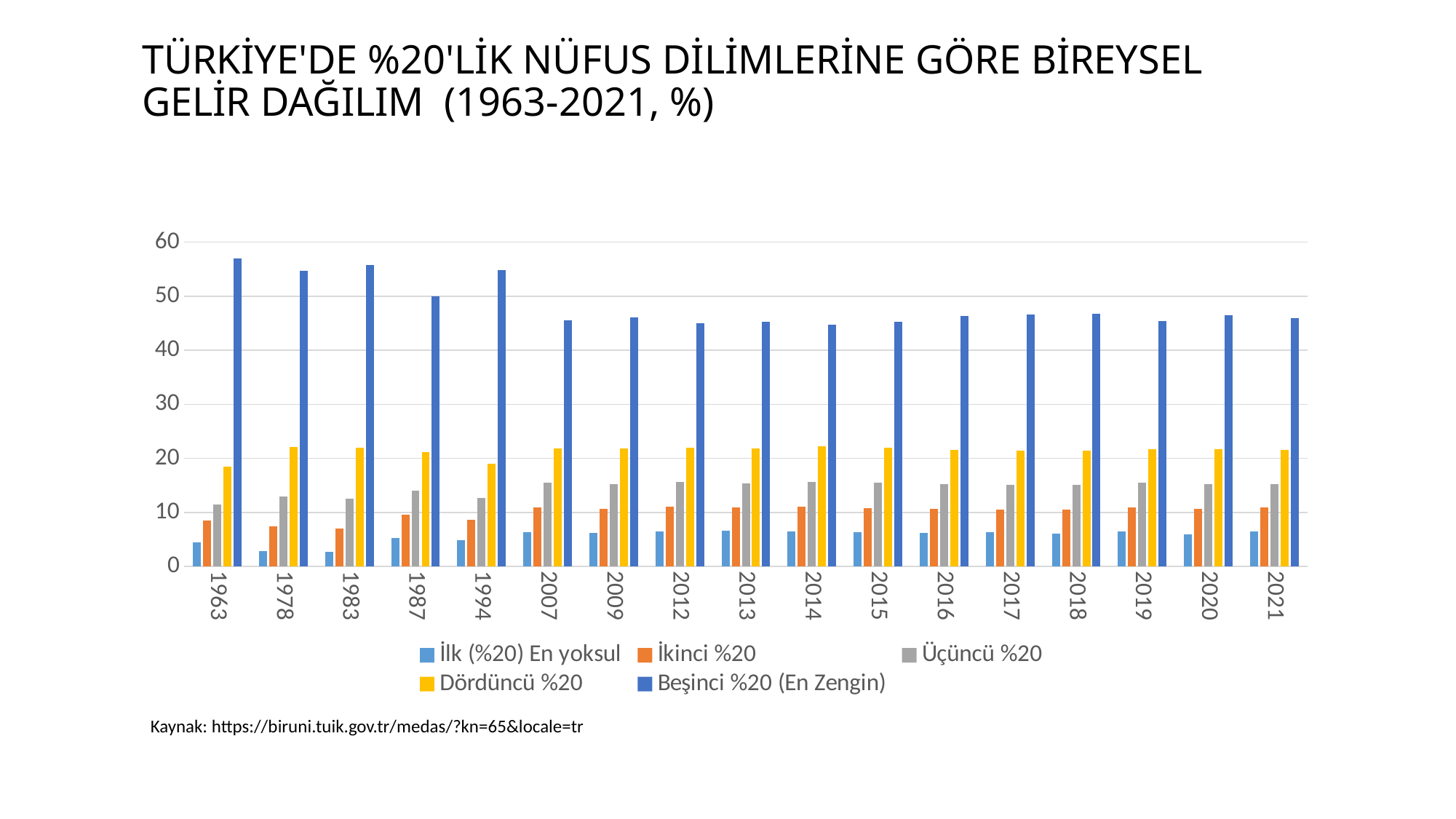
Which is larger for Beşinci %20 (En Zengin): the value in 1963 or the value in 2021? 1963 How many years are shown on the x axis? 17 Is the value for Dördüncü %20 in 1963 greater or less than 20? less Is the value for İlk (%20) En yoksul in 1963 greater or less than 10? less Overall, does the share of Beşinci %20 (En Zengin) rise or fall from 1963 to 2021? fall What kind of chart is shown on the slide? bar chart How many series does the legend list? 5 Is the value for Beşinci %20 (En Zengin) in 1963 greater or less than 50? greater Which series is shown in dark blue in the legend? Beşinci %20 (En Zengin) Which is larger for Dördüncü %20: the value in 1963 or the value in 1978? 1978